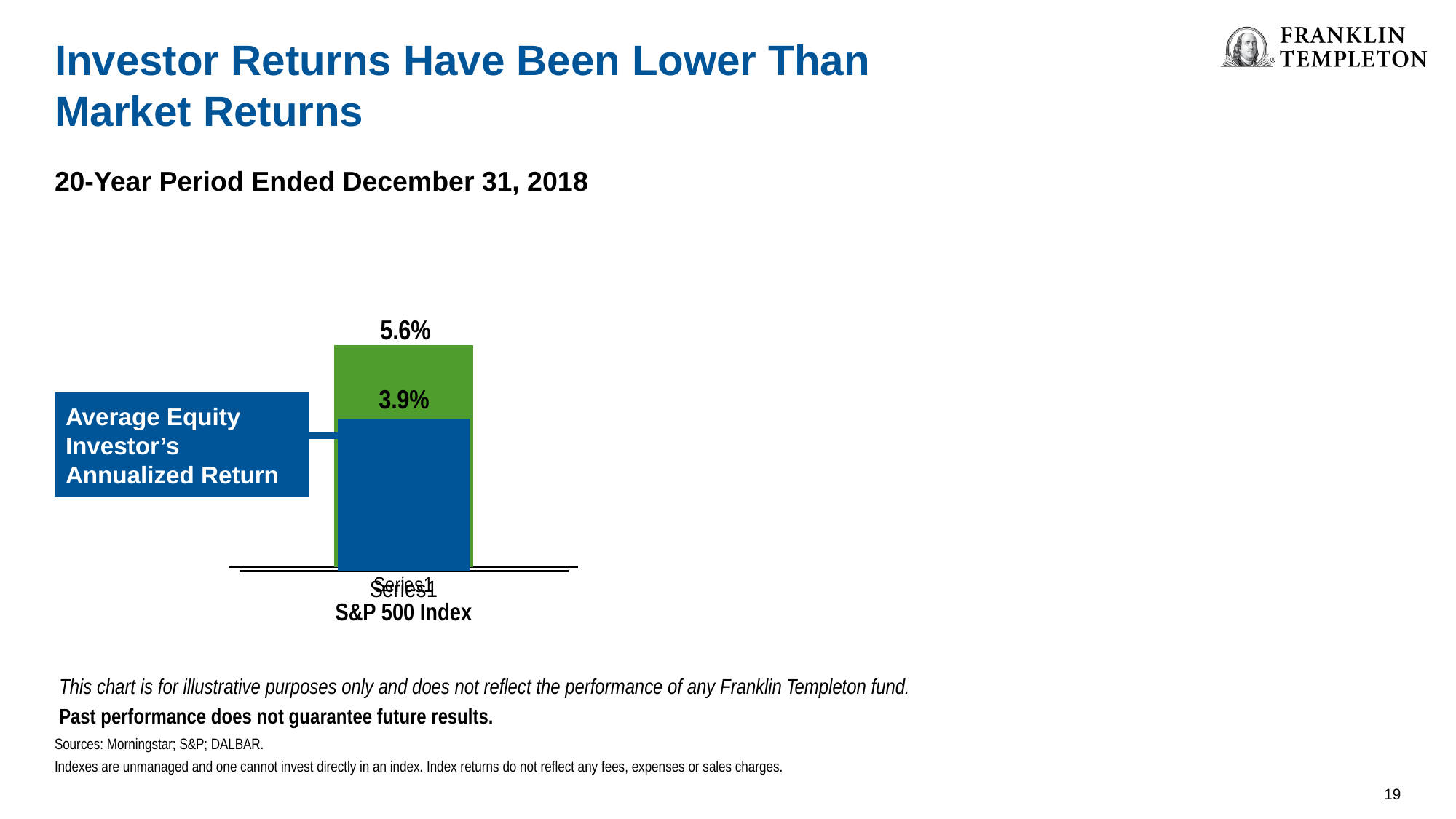
What colour is the bar segment representing the S&P 500 Index? Green Which is higher, the S&P 500 Index return or the Average Equity Investor's Annualized Return? S&P 500 Index Which of the two returns shown on the chart is the lowest? Average Equity Investor's Annualized Return What is the annualized return shown for the S&P 500 Index? 5.6% What time period does the chart cover, according to the subtitle? 20-Year Period Ended December 31, 2018 What kind of chart is shown on the slide? Bar chart By how many percentage points does the S&P 500 Index return exceed the Average Equity Investor's Annualized Return? 1.7 percentage points What is the Average Equity Investor's Annualized Return shown on the chart? 3.9% Which of the two returns shown on the chart is the highest? S&P 500 Index How many return values are labeled on the chart? 2